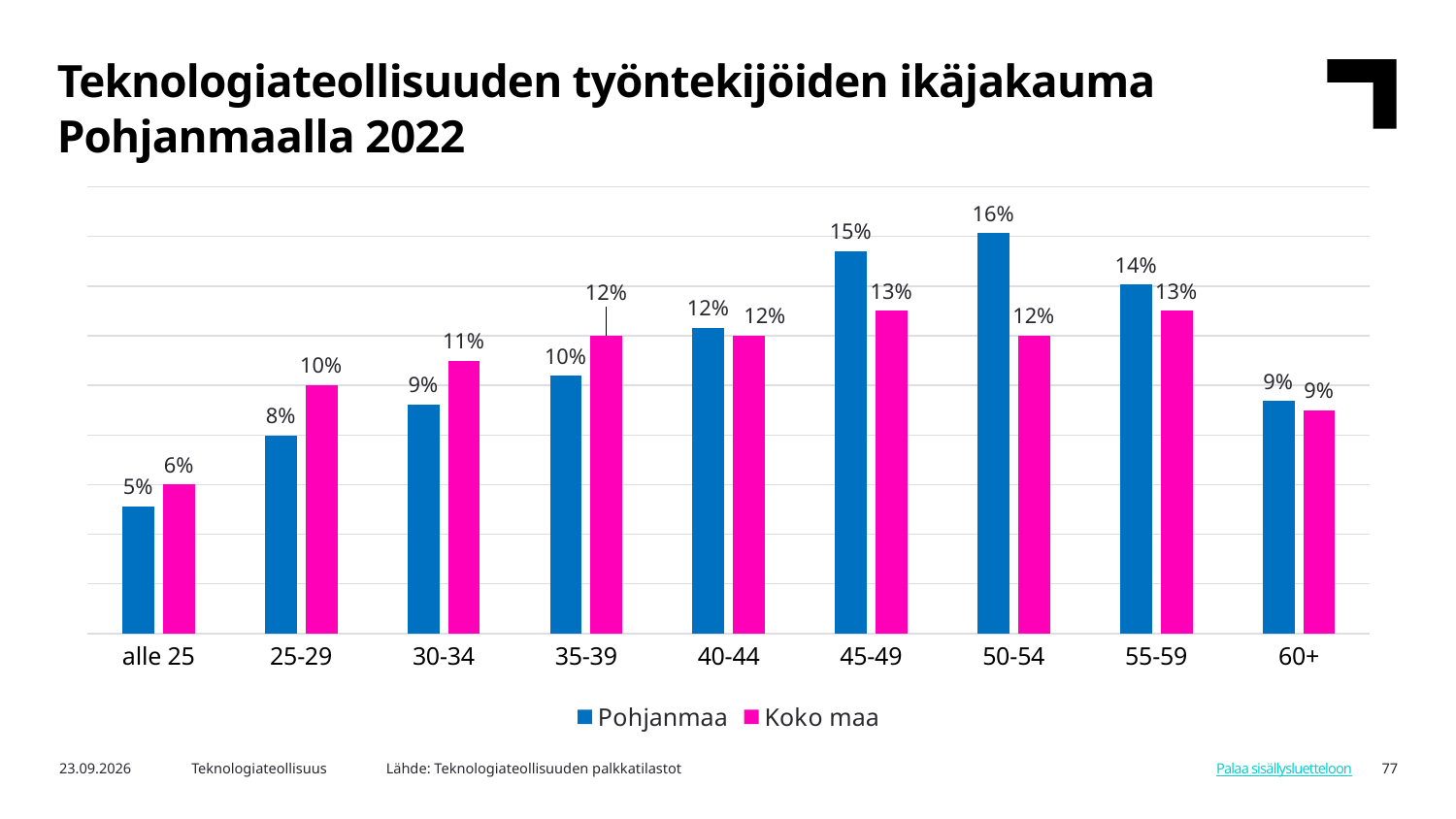
In the 30-34 age group, which series has the larger value, Pohjanmaa or Koko maa? Koko maa What is the value for Pohjanmaa in the 50-54 age group? 16% In the 45-49 age group, which series has the larger value, Pohjanmaa or Koko maa? Pohjanmaa What is the value for Pohjanmaa in the alle 25 age group? 5% What is the difference between Pohjanmaa and Koko maa in the 50-54 age group? 4 percentage points Which age group has the highest value for Pohjanmaa? 50-54 Which age group has the lowest value for Koko maa? alle 25 What kind of chart is shown on the slide? Bar chart What is the value for Koko maa in the 25-29 age group? 10% How many age groups are shown on the x axis? 9 Which series is shown in pink? Koko maa How many series does the legend list? 2